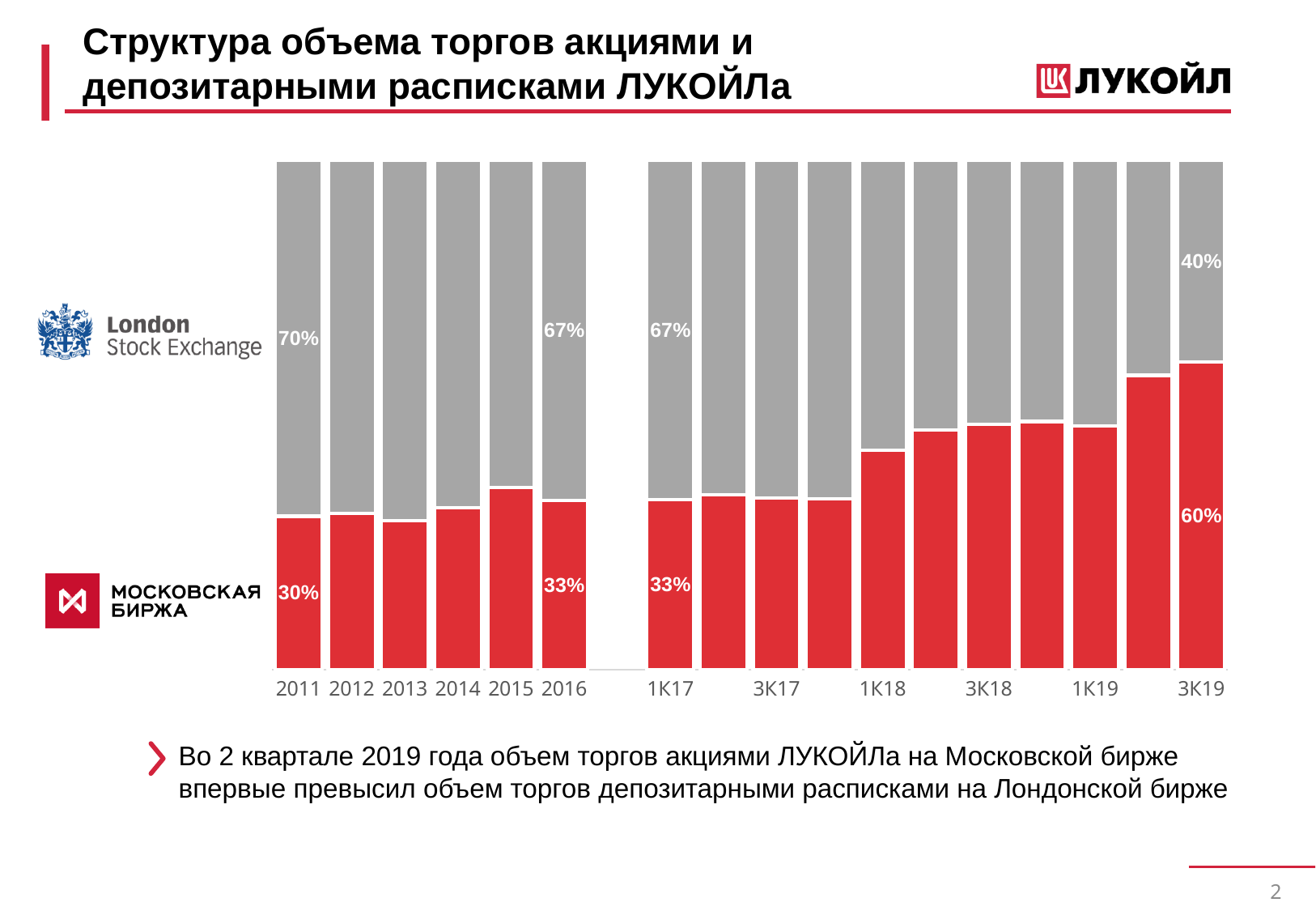
What colour represents the Moscow Exchange in the chart? Red What share of LUKOIL trading volume did the Moscow Exchange account for in 2011? 30% What is the London Stock Exchange share in 1К17? 67% In 3К19, which exchange has the larger share of trading volume, the Moscow Exchange or the London Stock Exchange? Moscow Exchange What is the Moscow Exchange share in 2016? 33% What share did the London Stock Exchange account for in 2011? 70% What kind of chart is shown on the slide? Stacked bar chart In 2011, by how many percentage points did the London Stock Exchange share exceed the Moscow Exchange share? 40 percentage points How many annual bars (2011 to 2016) are shown before the gap in the chart? 6 Does the Moscow Exchange share rise or fall from 1К17 to 3К19? Rises What is the London Stock Exchange share in 3К19? 40% What is the Moscow Exchange share in 3К19? 60%